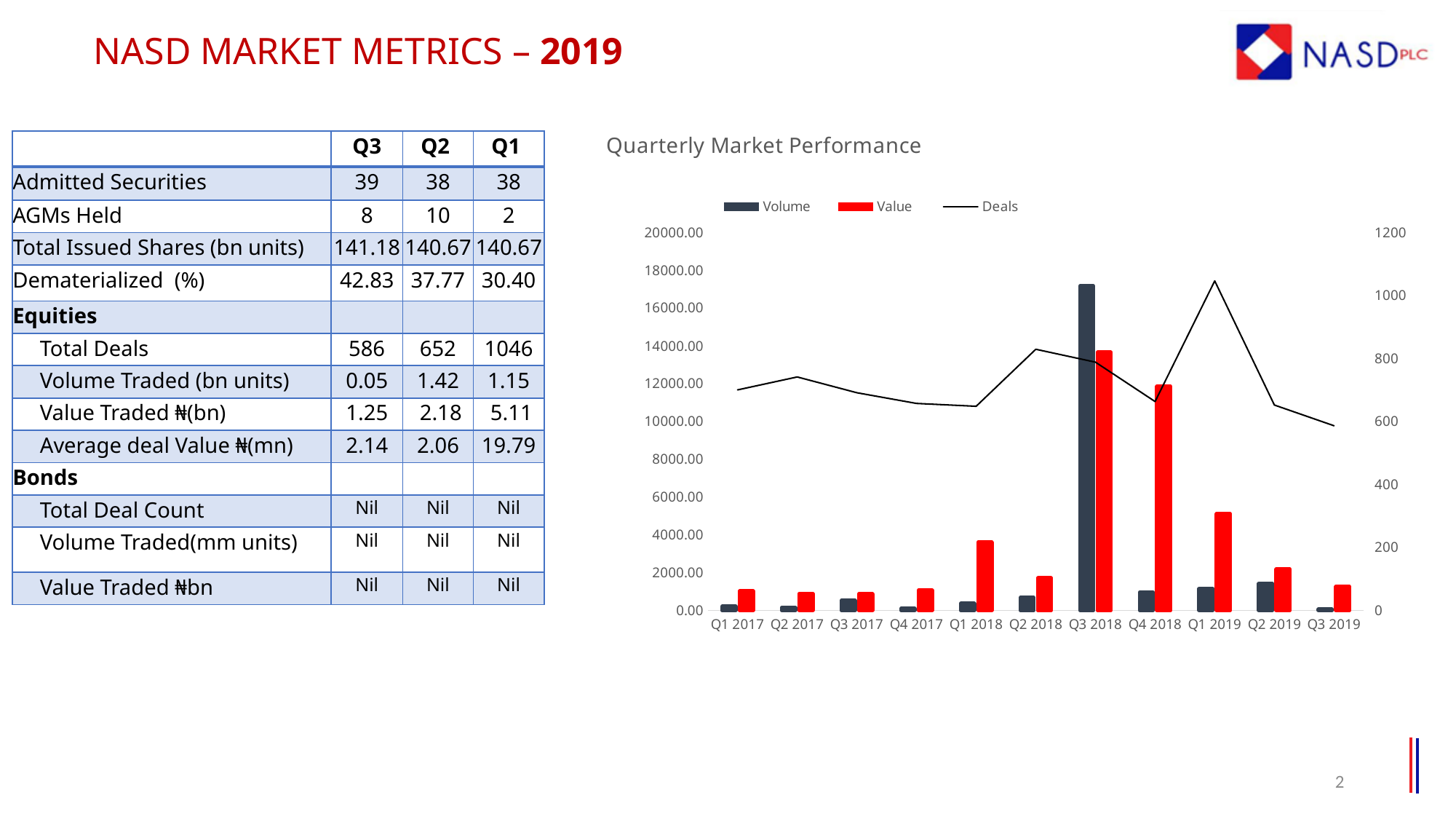
In the Quarterly Market Performance chart, is the Volume value for Q3 2018 greater or less than 16000? greater What kind of chart is the Quarterly Market Performance chart? A combined bar and line chart In the Quarterly Market Performance chart, does the Deals line rise or fall from Q1 2019 to Q3 2019? Fall In the Quarterly Market Performance chart, which quarter has the highest Value bar? Q3 2018 In the Quarterly Market Performance chart, which is larger: the Value bar for Q3 2018 or the Value bar for Q4 2018? Q3 2018 How many series does the legend of the Quarterly Market Performance chart list? 3 In the Quarterly Market Performance chart, in which quarter does the Deals line reach its peak? Q1 2019 In the Quarterly Market Performance chart, is the Deals value for Q3 2019 greater or less than 800 on the right axis? less In the Quarterly Market Performance chart, is the Value bar for Q1 2019 greater or less than 6000? less In the Quarterly Market Performance chart, which quarter has the highest Volume bar? Q3 2018 How many quarters are shown on the x axis of the Quarterly Market Performance chart? 11 Which series in the Quarterly Market Performance chart is drawn as a line rather than bars? Deals